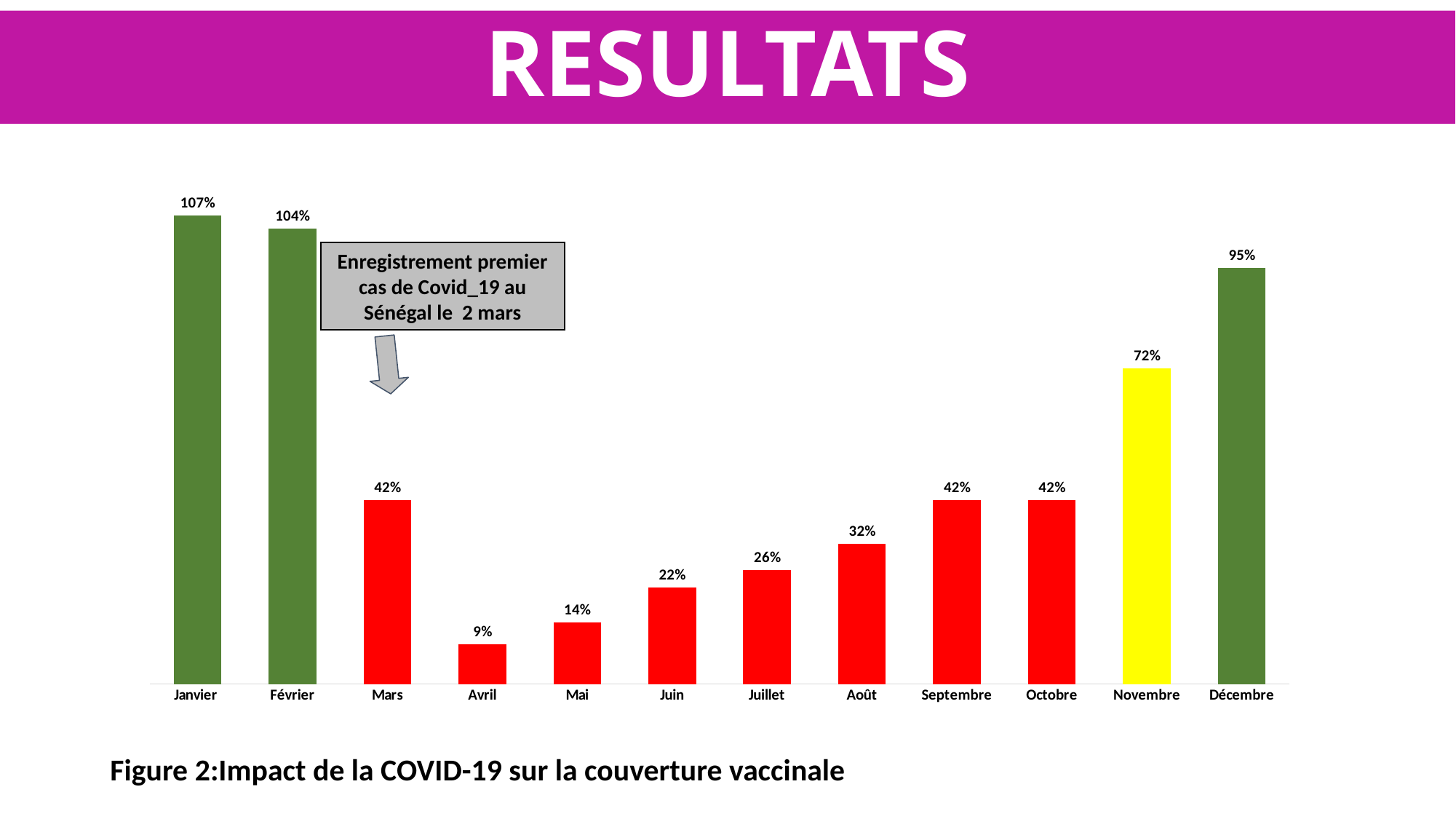
How many months are shown on the x axis? 12 Do the values rise or fall from Avril to Septembre? Rise What is the value for Janvier? 107% Which month has the highest value? Janvier Which is larger, the value for Décembre or the value for Novembre? Décembre What is the difference between the values for Février and Mars? 62% What is the value for Novembre? 72% What colour is the bar for Novembre? Yellow What is the difference between the values for Décembre and Juin? 73% Which month has the lowest value? Avril What kind of chart is this? Bar chart What is the value for Avril? 9%